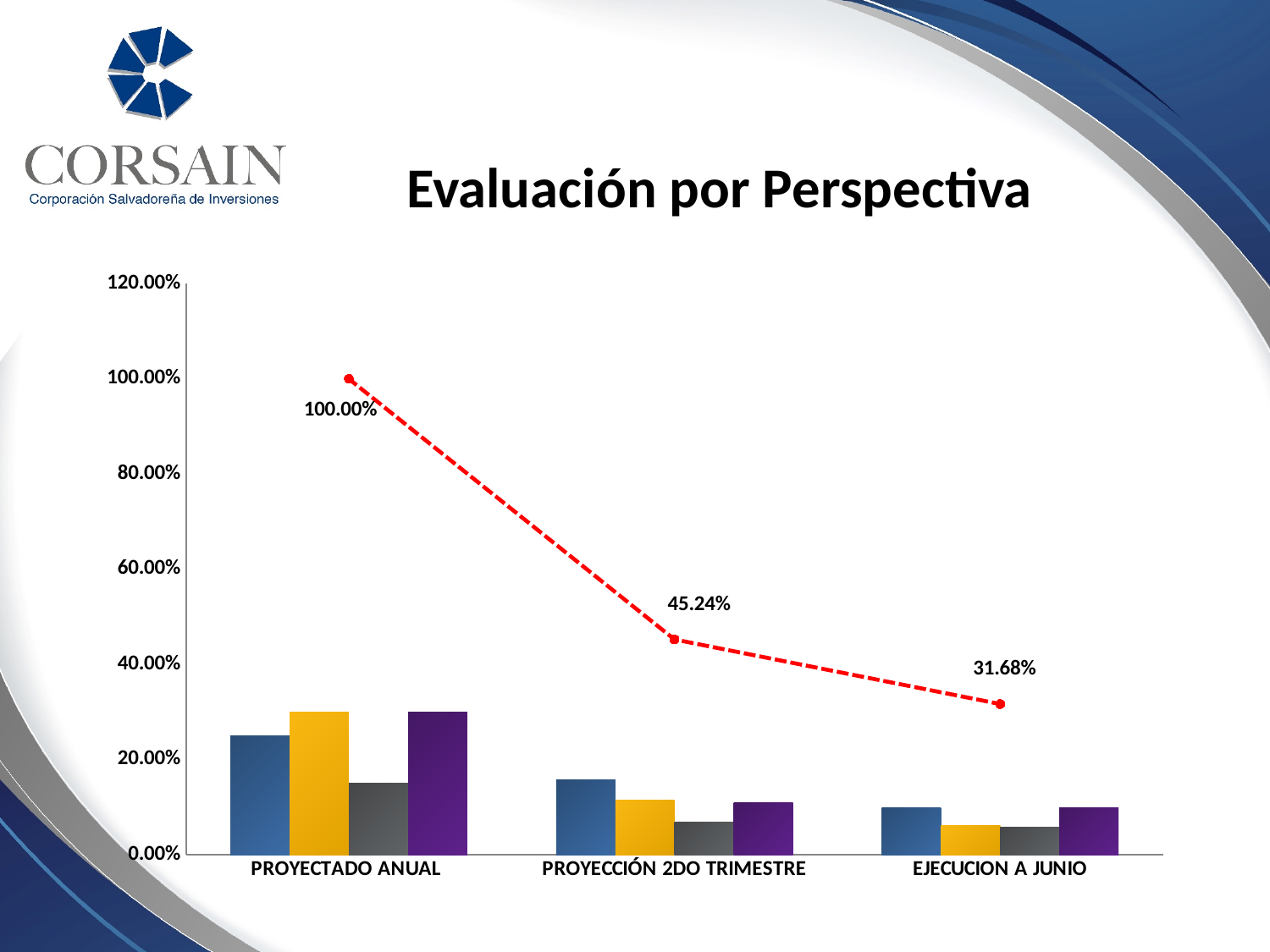
How many categories are shown on the x axis? 3 For which category is the dashed red line value lowest? EJECUCION A JUNIO What value does the dashed red line show for EJECUCION A JUNIO? 31.68% What is the difference between the line values for PROYECCIÓN 2DO TRIMESTRE and EJECUCION A JUNIO? 13.56% Is the blue bar for EJECUCION A JUNIO greater or less than 20.00%? less What is the title of the chart? Evaluación por Perspectiva What value does the dashed red line show for PROYECCIÓN 2DO TRIMESTRE? 45.24% What is the difference between the line values for PROYECTADO ANUAL and PROYECCIÓN 2DO TRIMESTRE? 54.76% What value does the dashed red line show for PROYECTADO ANUAL? 100.00% For which category is the dashed red line value highest? PROYECTADO ANUAL Does the dashed red line rise or fall from PROYECTADO ANUAL to EJECUCION A JUNIO? fall Is the yellow bar for PROYECTADO ANUAL greater or less than 20.00%? greater